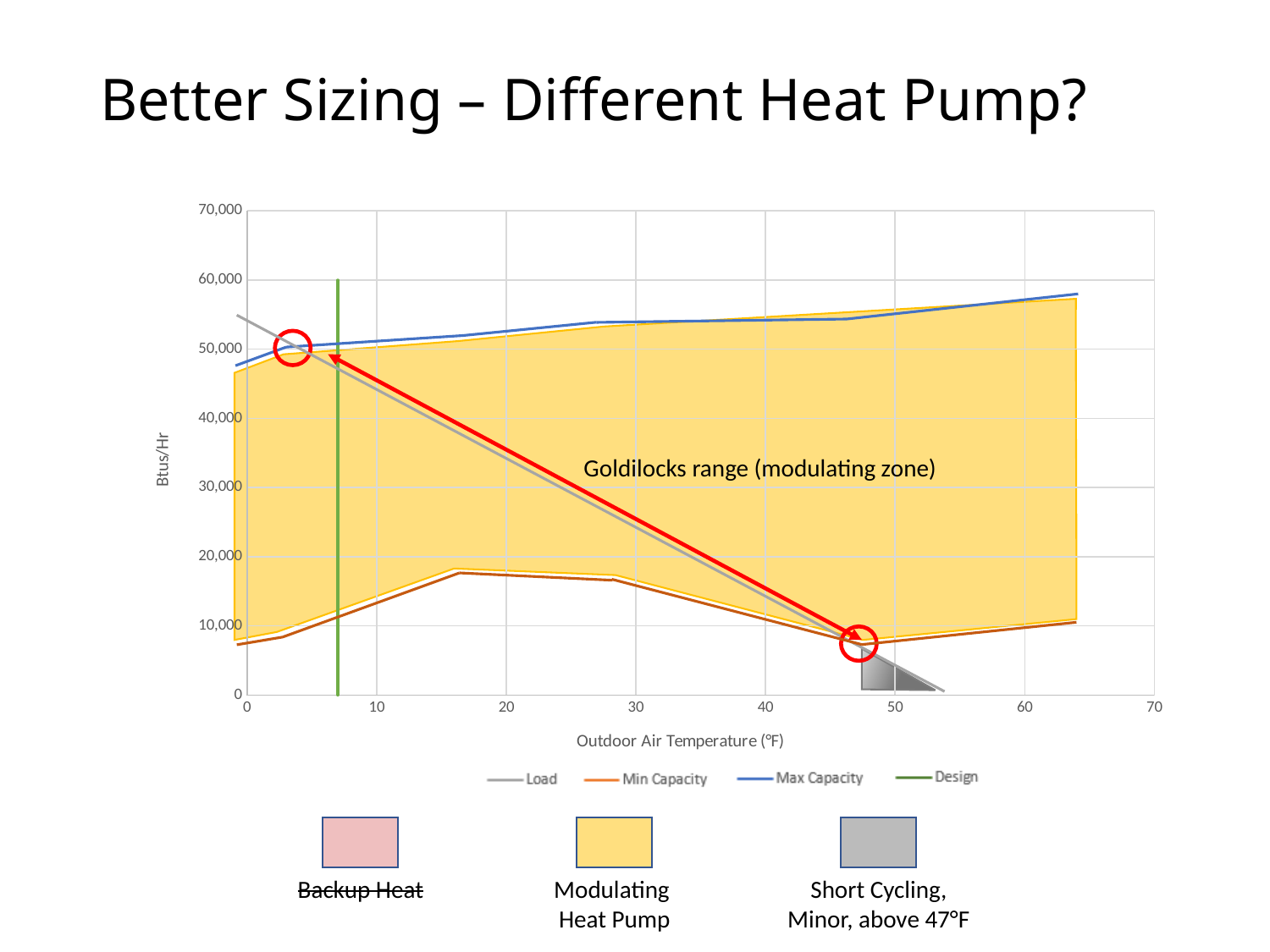
Is the Load value at 40°F greater or less than 20,000? less At 20°F, which is larger: the Load value or the Min Capacity value? Load Does the Load series rise or fall as outdoor air temperature increases? fall Is the Max Capacity value at 60°F greater or less than 50,000? greater What kind of chart is shown on the slide? line chart How many series does the chart legend list? 4 Is the Load value at 0°F greater or less than 50,000? greater Does the Max Capacity series generally rise or fall as outdoor air temperature increases? rise What are the series names listed in the chart legend? Load, Min Capacity, Max Capacity, Design What is the title of the chart's vertical axis? Btus/Hr